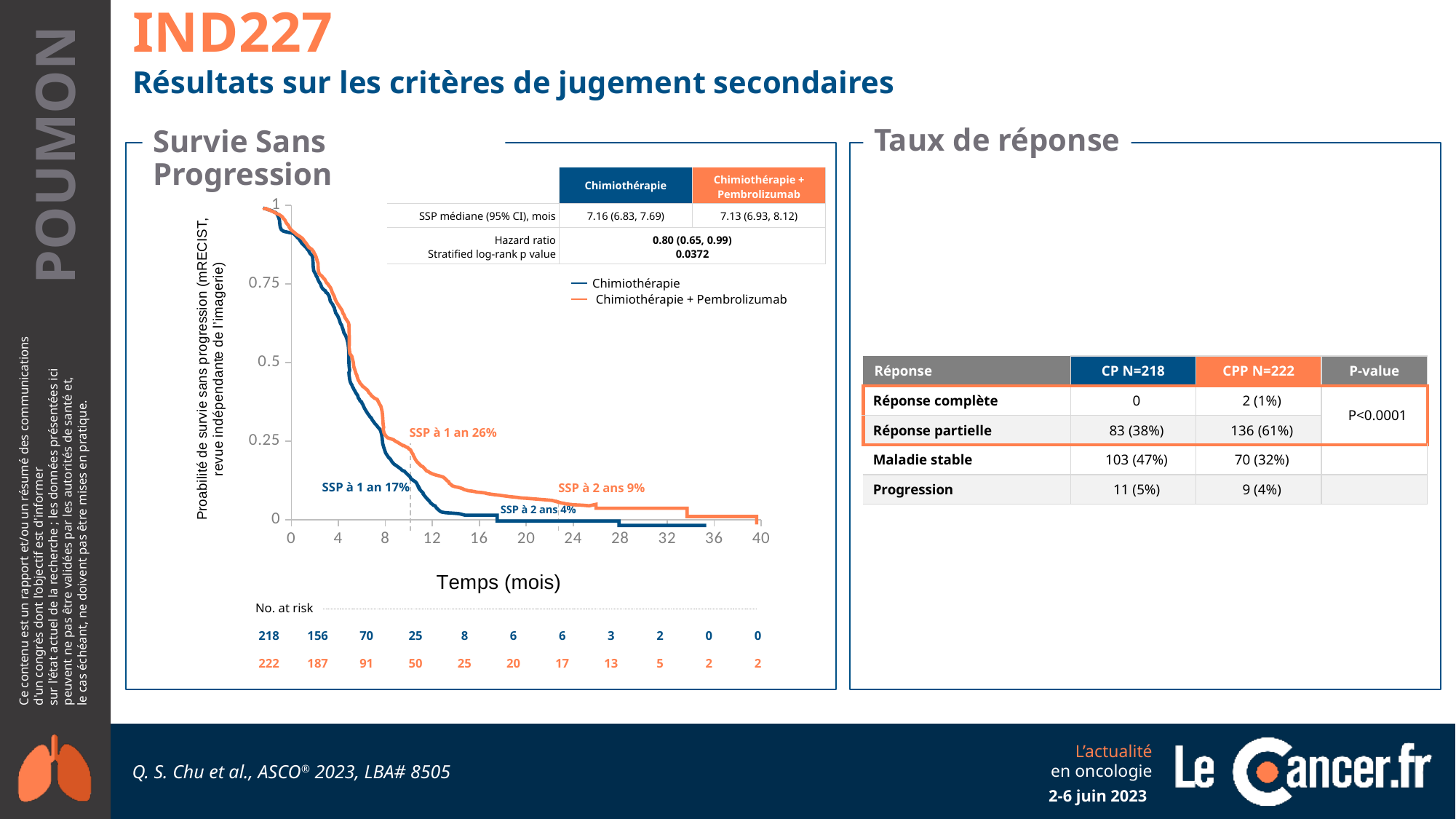
In the 'Survie Sans Progression' chart, which arm has the higher SSP à 2 ans? Chimiothérapie + Pembrolizumab In the 'Survie Sans Progression' chart, what is the SSP à 1 an for Chimiothérapie? 17% In the 'Survie Sans Progression' chart, what is the SSP à 2 ans for Chimiothérapie? 4% In the 'Survie Sans Progression' chart, is the Chimiothérapie curve at 8 months greater or less than 0.5? less In the 'Survie Sans Progression' chart, how many patients were at risk at time 0 in the Chimiothérapie + Pembrolizumab arm? 222 What kind of chart is shown in the 'Survie Sans Progression' panel? line chart In the 'Survie Sans Progression' chart, what is the SSP à 1 an for Chimiothérapie + Pembrolizumab? 26% In the 'Survie Sans Progression' chart, do the survival curves rise or fall as time increases? fall In the 'Survie Sans Progression' chart, what is the difference in SSP à 1 an between Chimiothérapie + Pembrolizumab and Chimiothérapie? 9 percentage points In the 'Survie Sans Progression' chart, what colour is the Chimiothérapie + Pembrolizumab curve? orange In the 'Survie Sans Progression' chart, what is the SSP à 2 ans for Chimiothérapie + Pembrolizumab? 9% How many series does the legend of the 'Survie Sans Progression' chart list? 2